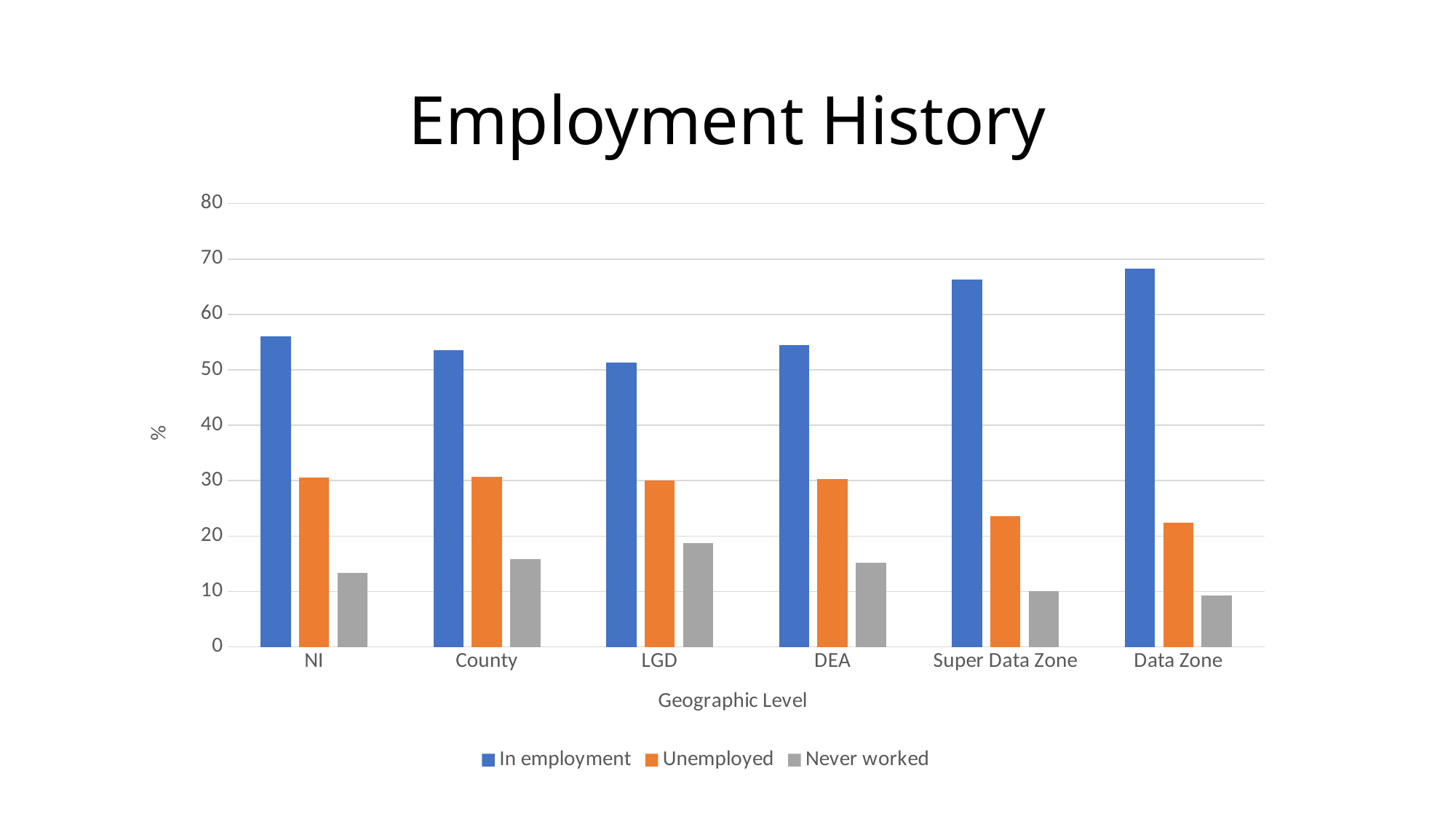
Is the Unemployed value for Super Data Zone greater or less than 30? less Which geographic level has the highest In employment value? Data Zone How many series does the legend list? 3 Which is larger, the In employment value for NI or for County? NI Which is larger, the Never worked value for LGD or for DEA? LGD Which geographic level has the lowest In employment value? LGD Is the Never worked value for LGD greater or less than 20? less What kind of chart is shown on the slide? bar chart How many geographic levels are shown on the x axis? 6 What is the title of the chart? Employment History Which geographic level has the highest Never worked value? LGD Is the In employment value for Super Data Zone greater or less than 60? greater